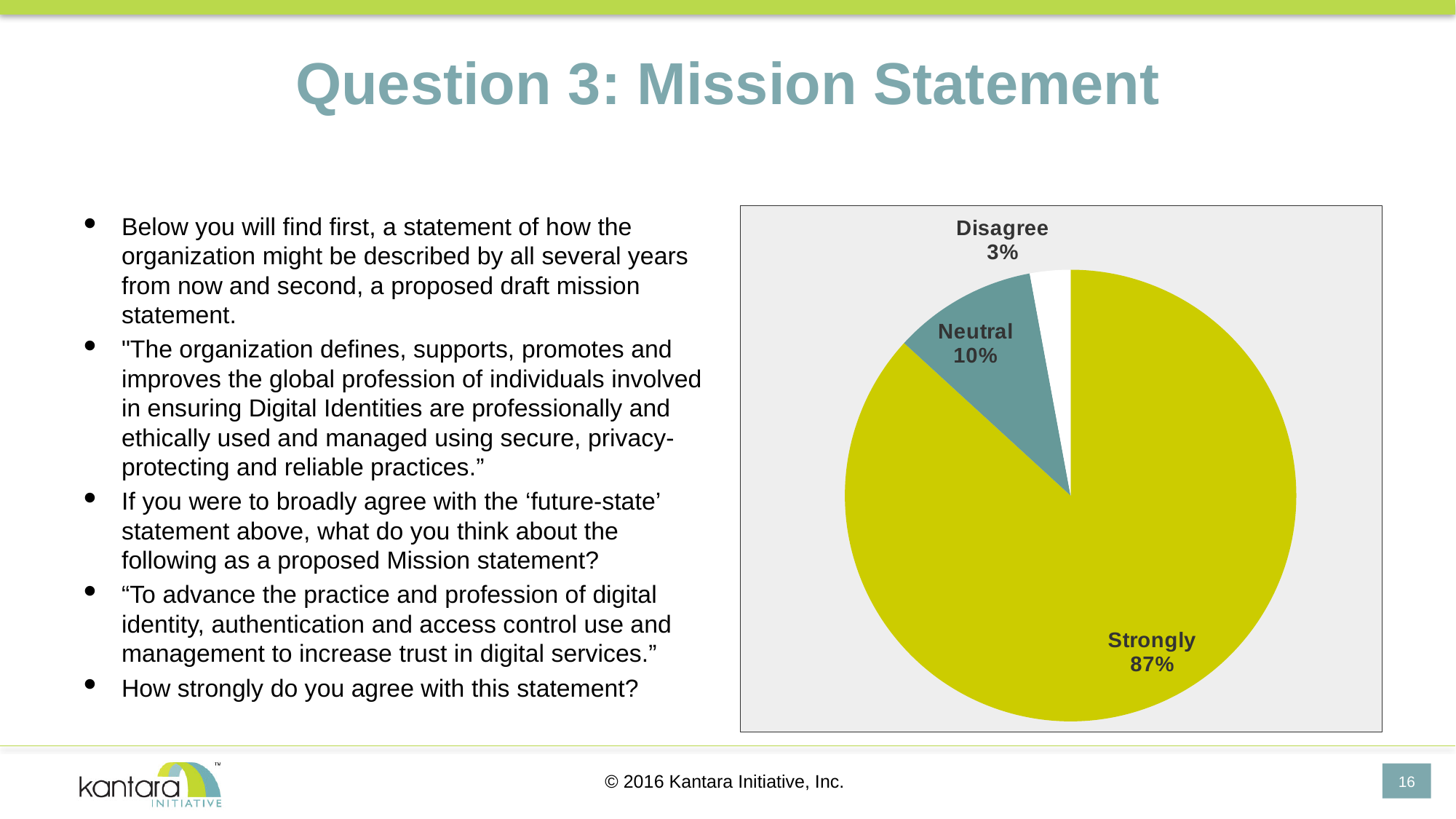
What share of the pie does the Neutral slice represent? 10% What colour is the Neutral slice of the pie? teal What share of the pie does the Disagree slice represent? 3% How many slices does the pie chart have? 3 Which is larger, the Neutral slice or the Disagree slice? Neutral Which slice of the pie is the largest? Strongly Which slice of the pie is the smallest? Disagree What is the difference in percentage points between the Neutral and Disagree slices? 7 What kind of chart is shown on the slide? pie chart What share of the pie does the Strongly slice represent? 87% What colour is the Strongly slice of the pie? yellow-green What is the difference in percentage points between the Strongly and Neutral slices? 77